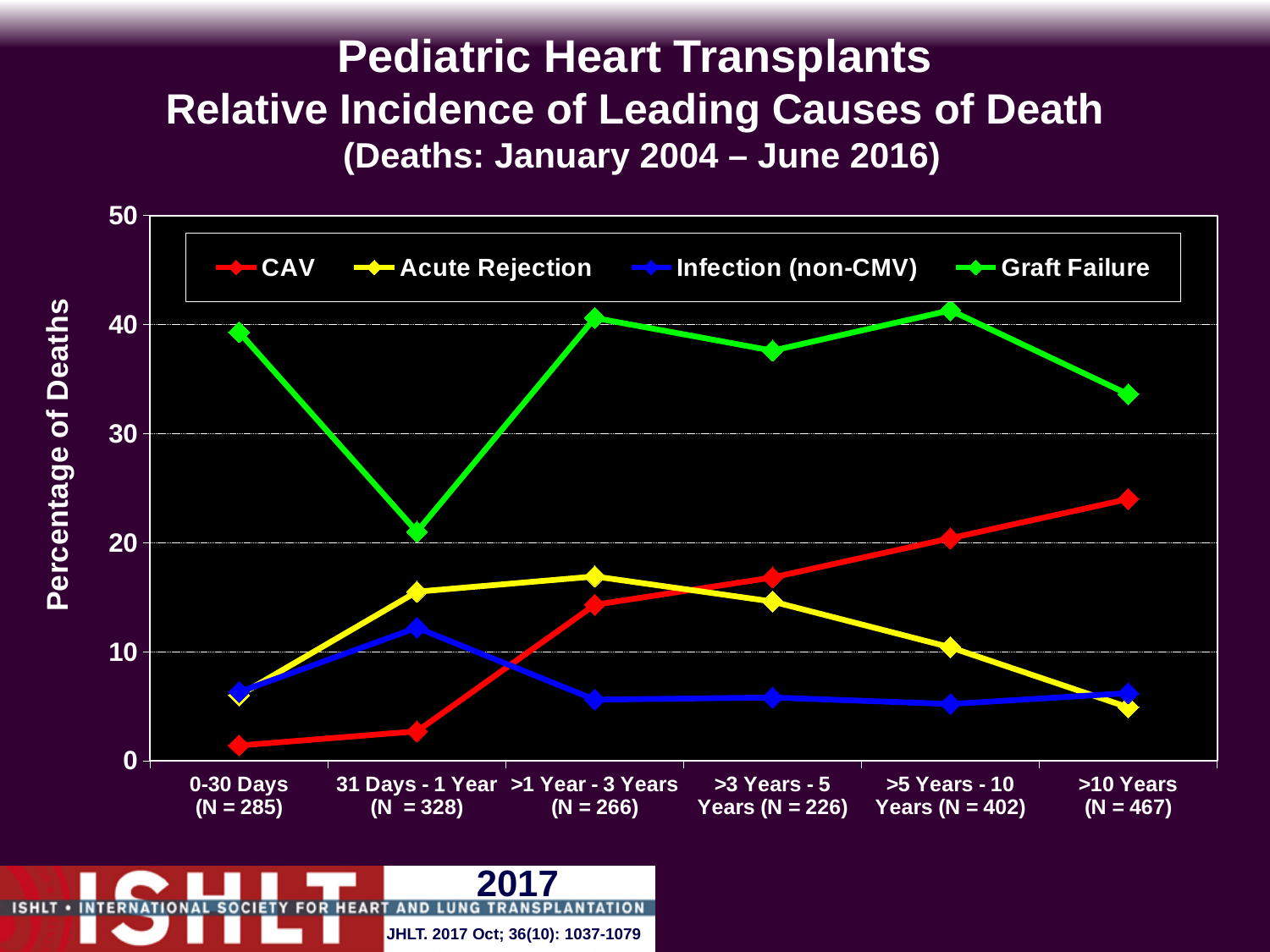
Which cause of death has the lowest percentage at 0-30 Days? CAV Is the CAV value for >10 Years greater or less than 20? greater Is the Graft Failure value for 0-30 Days greater or less than 30? greater Which cause of death has the highest percentage at >5 Years - 10 Years? Graft Failure How many time-interval categories are shown on the x axis? 6 What kind of chart is shown on the slide? line chart Does the CAV series rise or fall across the time intervals from 0-30 Days to >10 Years? rise At >10 Years, which is larger: CAV or Acute Rejection? CAV In which time interval is the Graft Failure percentage lowest? 31 Days - 1 Year How many series does the legend list? 4 Is the Graft Failure value for 31 Days - 1 Year greater or less than 30? less